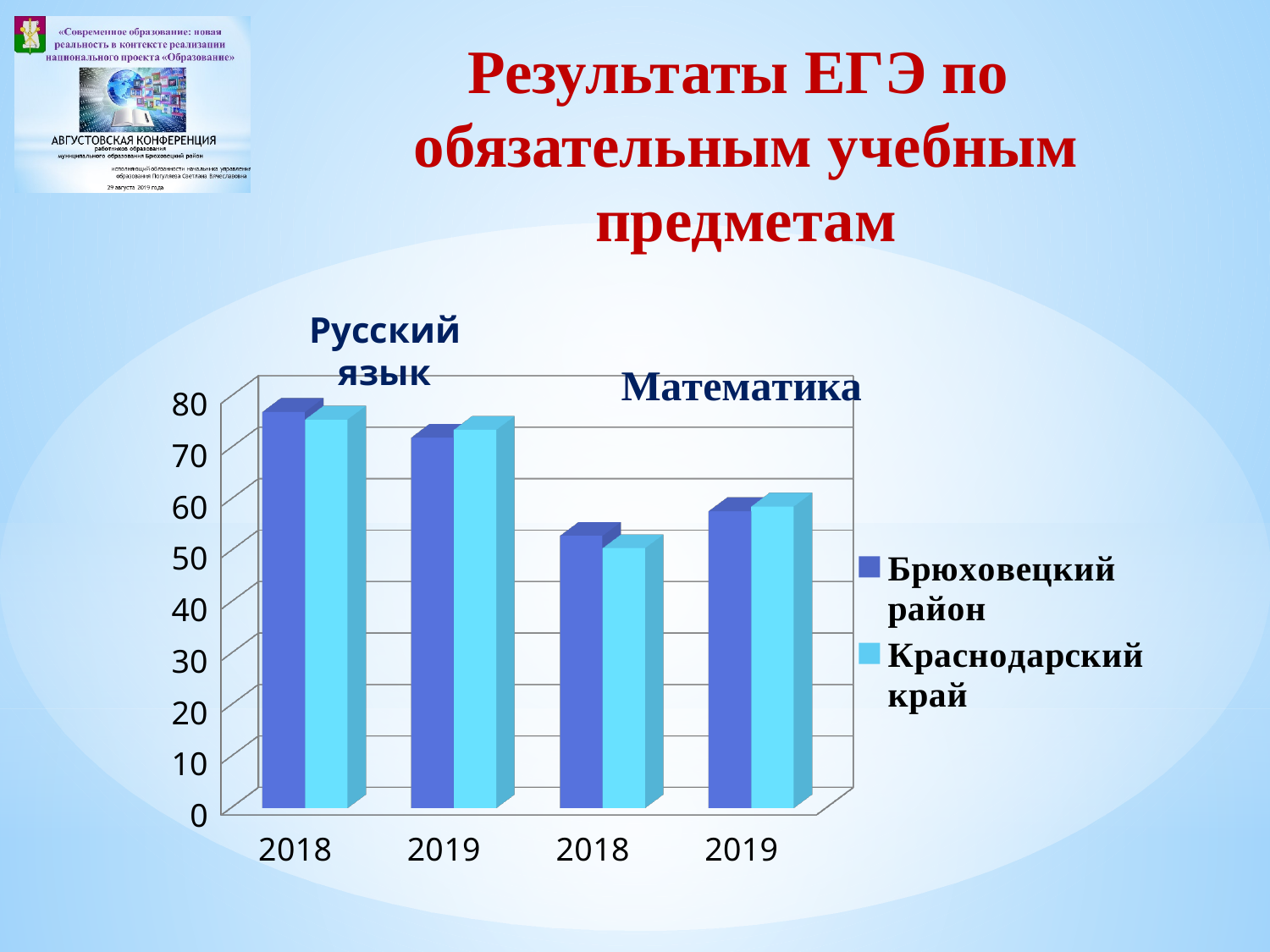
Which is larger for Брюховецкий район: the value for Русский язык 2018 or Математика 2018? Русский язык 2018 For Брюховецкий район, which category has the highest bar? Русский язык 2018 How many series does the legend list? 2 For Краснодарский край, which category has the lowest bar? Математика 2018 How many categories are shown along the x axis? 4 Which two series are listed in the legend? Брюховецкий район and Краснодарский край Is the value for Краснодарский край in Русский язык 2019 greater or less than 70? greater What kind of chart is shown on the slide? bar chart Is the value for Брюховецкий район in Русский язык 2018 greater or less than 70? greater Which two subjects are labelled on the chart? Русский язык and Математика Is the value for Брюховецкий район in Математика 2019 greater or less than 50? greater